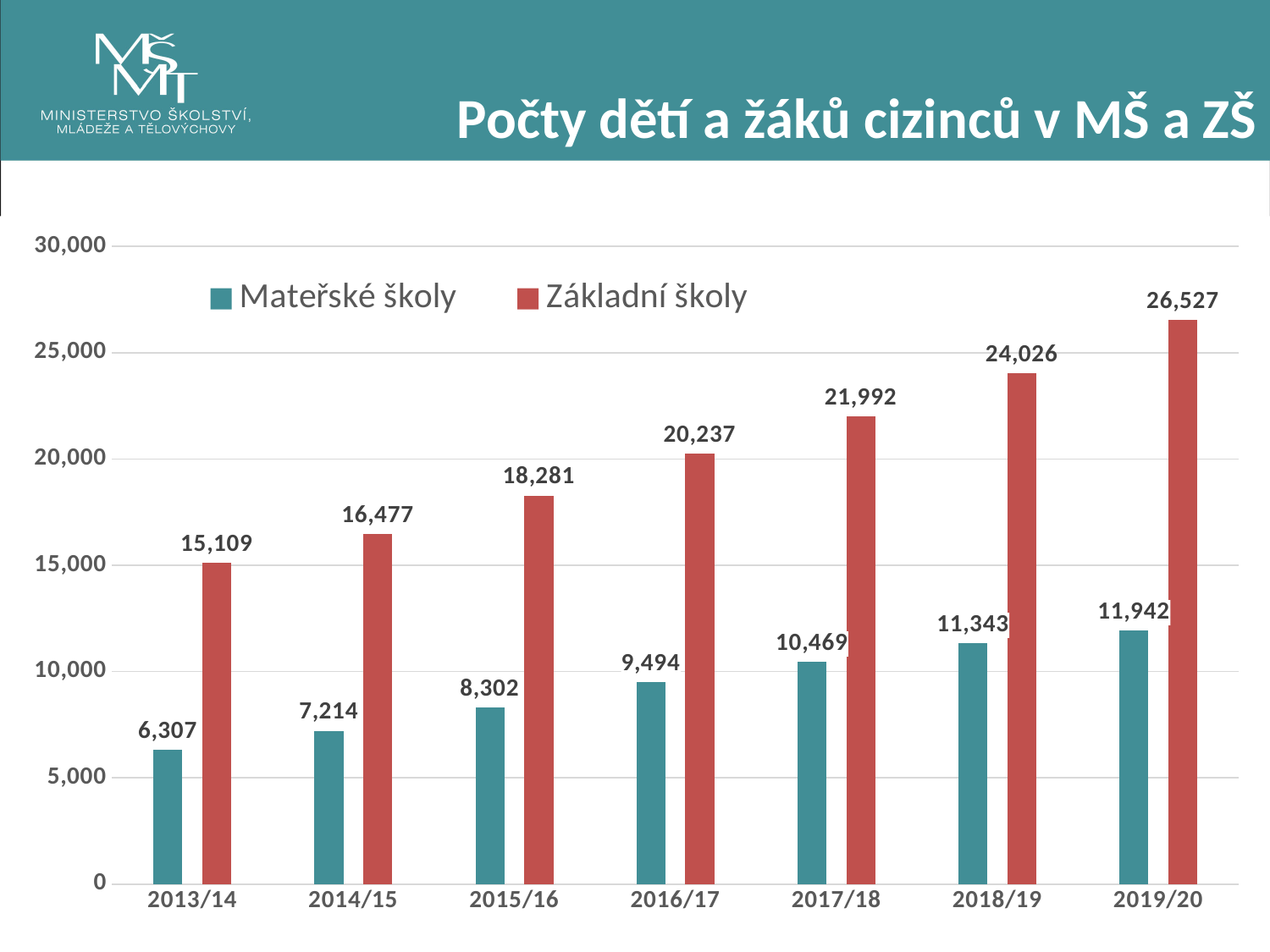
What kind of chart is shown on the slide? Bar chart In which school year is the value for Základní školy highest? 2019/20 Do the values for Základní školy rise or fall from 2013/14 to 2019/20? Rise What is the value for Mateřské školy in 2018/19? 11,343 What is the value for Mateřské školy in 2013/14? 6,307 What is the difference between Základní školy and Mateřské školy in 2019/20? 14,585 How many school years are shown on the x axis? 7 What is the value for Základní školy in 2016/17? 20,237 What is the title of the chart? Počty dětí a žáků cizinců v MŠ a ZŠ How many series does the legend list? 2 Which is larger in 2015/16: Mateřské školy or Základní školy? Základní školy In which school year is the value for Mateřské školy lowest? 2013/14